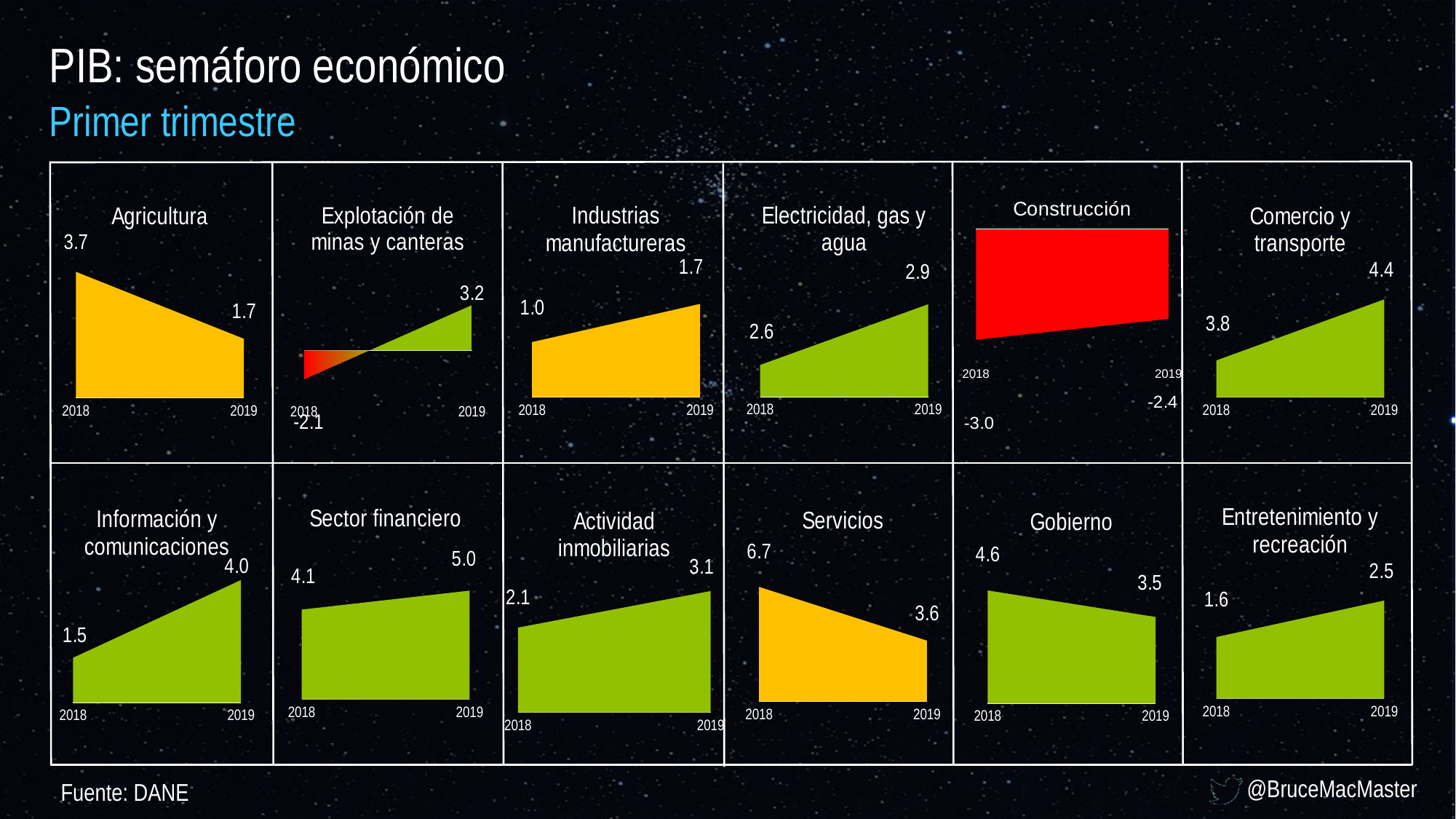
In the Información y comunicaciones chart, does the value rise or fall from 2018 to 2019? rise In the Comercio y transporte chart, how many data points are plotted? 2 In the Servicios chart, what is the value for 2019? 3.6 What kind of chart is used in the Electricidad, gas y agua panel? area chart In the Agricultura chart, does the value rise or fall from 2018 to 2019? fall In the Construcción chart, what is the value for 2018? -3.0 In the Sector financiero chart, what is the value for 2019? 5.0 In the Servicios chart, what is the difference between the 2018 and 2019 values? 3.1 In the Información y comunicaciones chart, what is the difference between the 2019 and 2018 values? 2.5 In the Agricultura chart, what is the value for 2018? 3.7 In the Gobierno chart, which year has the larger value, 2018 or 2019? 2018 In the Explotación de minas y canteras chart, what is the value for 2019? 3.2